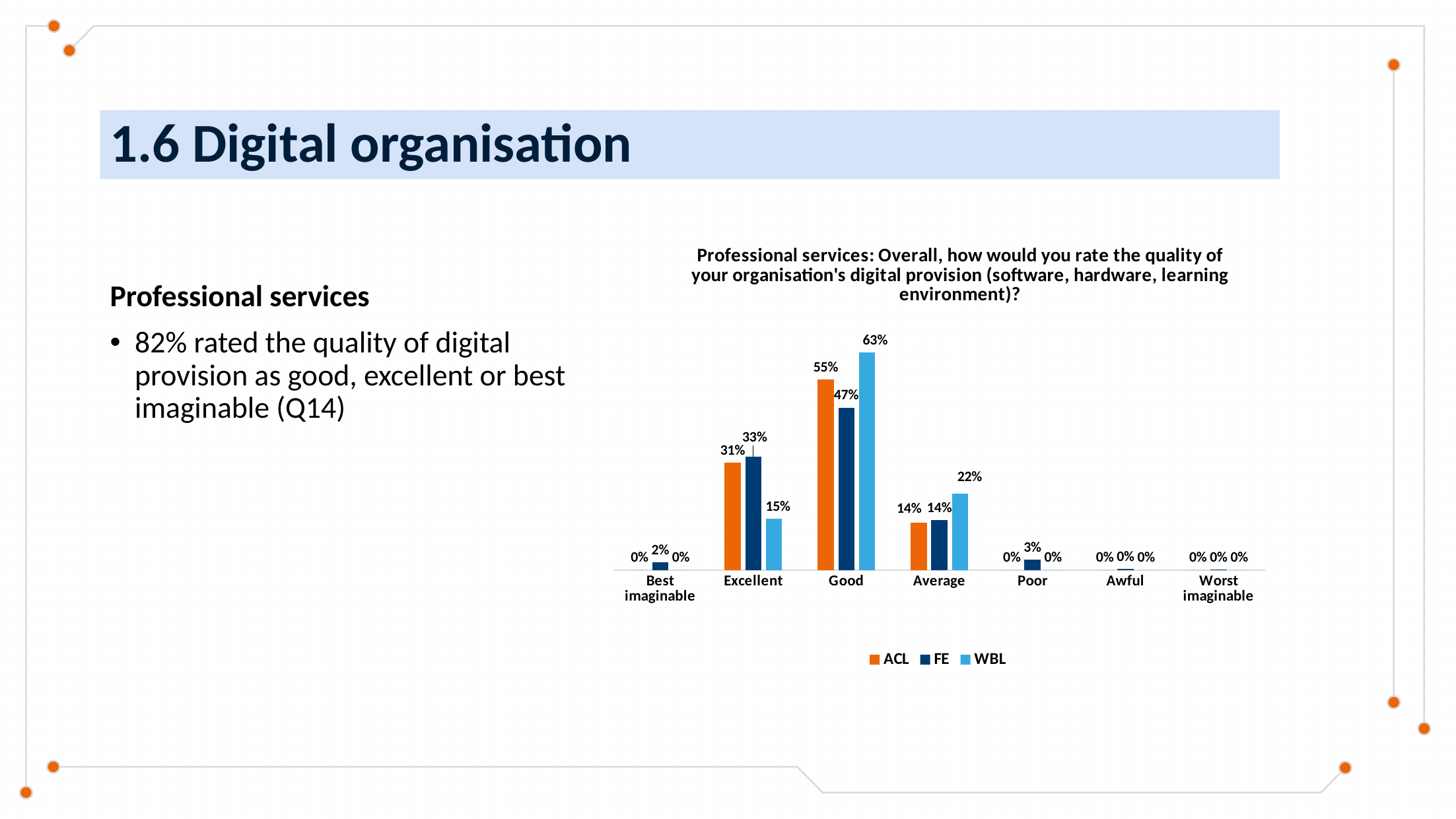
What is the ACL value for the Excellent category? 31% Which series has the lowest value in the Excellent category? WBL What kind of chart is shown on the slide? Bar chart What is the WBL value for the Average category? 22% Which category has the highest ACL value? Good What percentage of WBL respondents rated their organisation's digital provision as Good? 63% Which series is shown in orange in the legend? ACL How many series does the legend list? 3 What is the difference between the WBL and FE values for Good? 16% How many rating categories are shown on the x axis? 7 What is the FE value for the Poor category? 3% Which is larger for the Excellent category, the ACL value or the FE value? FE